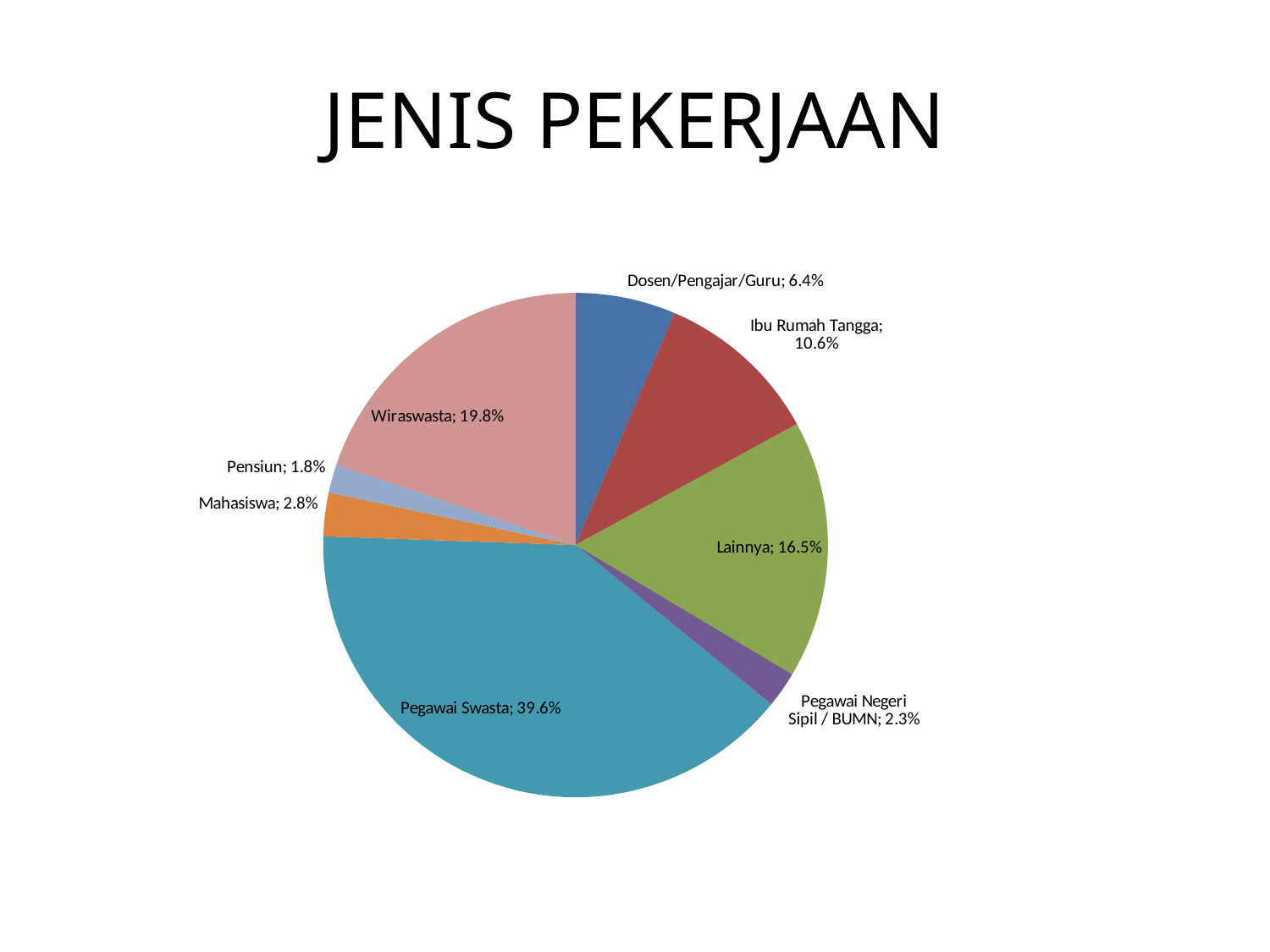
How many categories are shown in the pie chart? 8 What is the value for Wiraswasta? 19.8% Which category has the largest slice of the pie? Pegawai Swasta What is the title of the chart? JENIS PEKERJAAN What is the value for Pegawai Negeri Sipil / BUMN? 2.3% What share of the pie does Pegawai Swasta represent? 39.6% What is the value for Ibu Rumah Tangga? 10.6% What type of chart is shown on the slide? pie chart What is the difference between the values for Mahasiswa and Pensiun? 1.0% What is the difference between the values for Pegawai Swasta and Wiraswasta? 19.8% Which is larger, Lainnya or Ibu Rumah Tangga? Lainnya Which category has the smallest slice of the pie? Pensiun